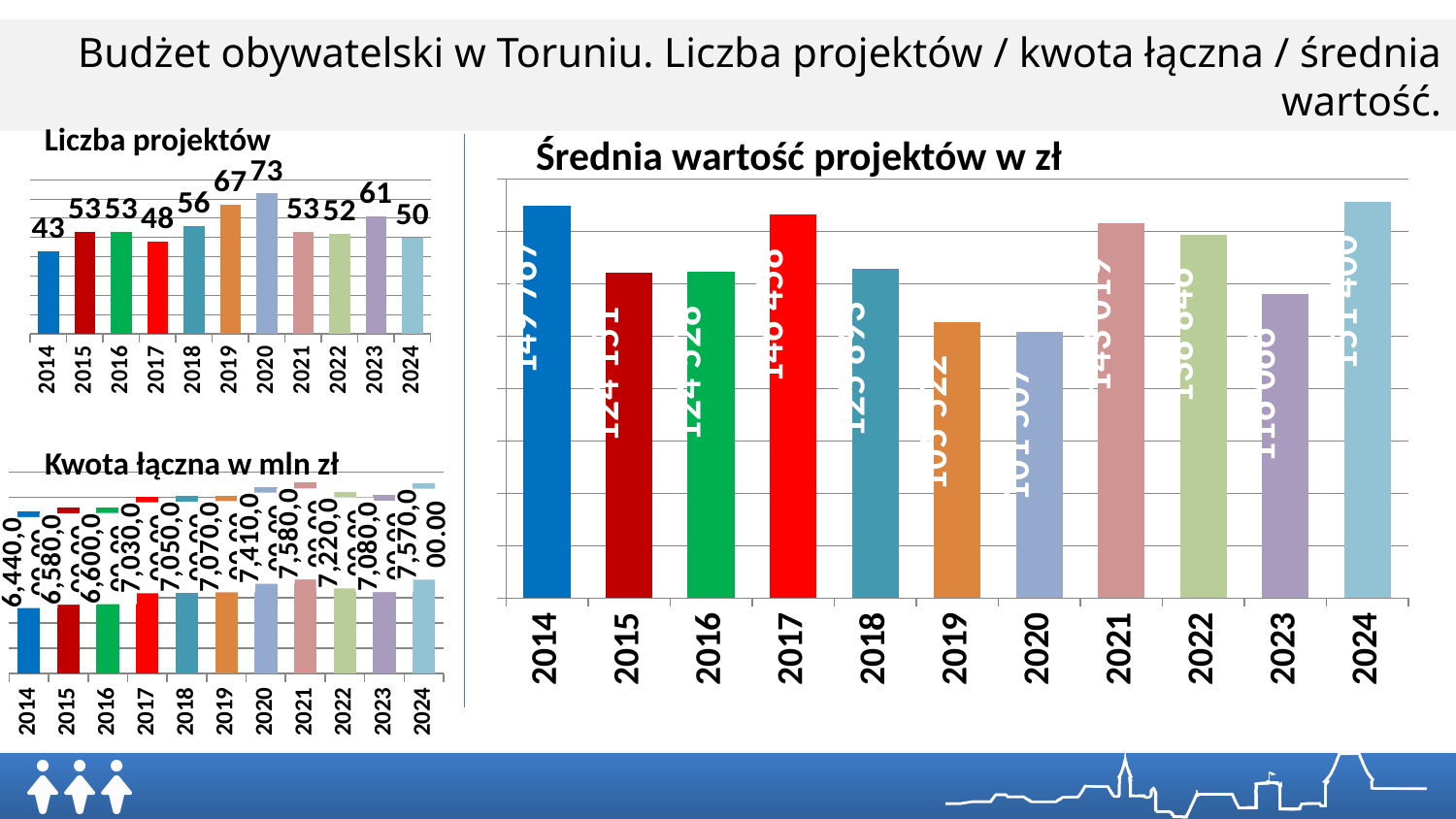
In the 'Liczba projektów' chart, what is the difference between the values for 2020 and 2014? 30 In the 'Liczba projektów' chart, what is the value for 2020? 73 In the 'Liczba projektów' chart, how many years are shown on the x axis? 11 In the 'Średnia wartość projektów w zł' chart, what is the value for 2024? 151 400 In the 'Średnia wartość projektów w zł' chart, which is larger, the value for 2021 or the value for 2023? 2021 What kind of chart is 'Średnia wartość projektów w zł'? bar chart In the 'Liczba projektów' chart, which year has the lowest value? 2014 In the 'Liczba projektów' chart, which year has the highest value? 2020 In the 'Liczba projektów' chart, which is larger, the value for 2019 or the value for 2023? 2019 What is the title of the chart on the right side of the slide? Średnia wartość projektów w zł In the 'Średnia wartość projektów w zł' chart, which is larger, the value for 2017 or the value for 2018? 2017 In the 'Liczba projektów' chart, what is the value for 2014? 43